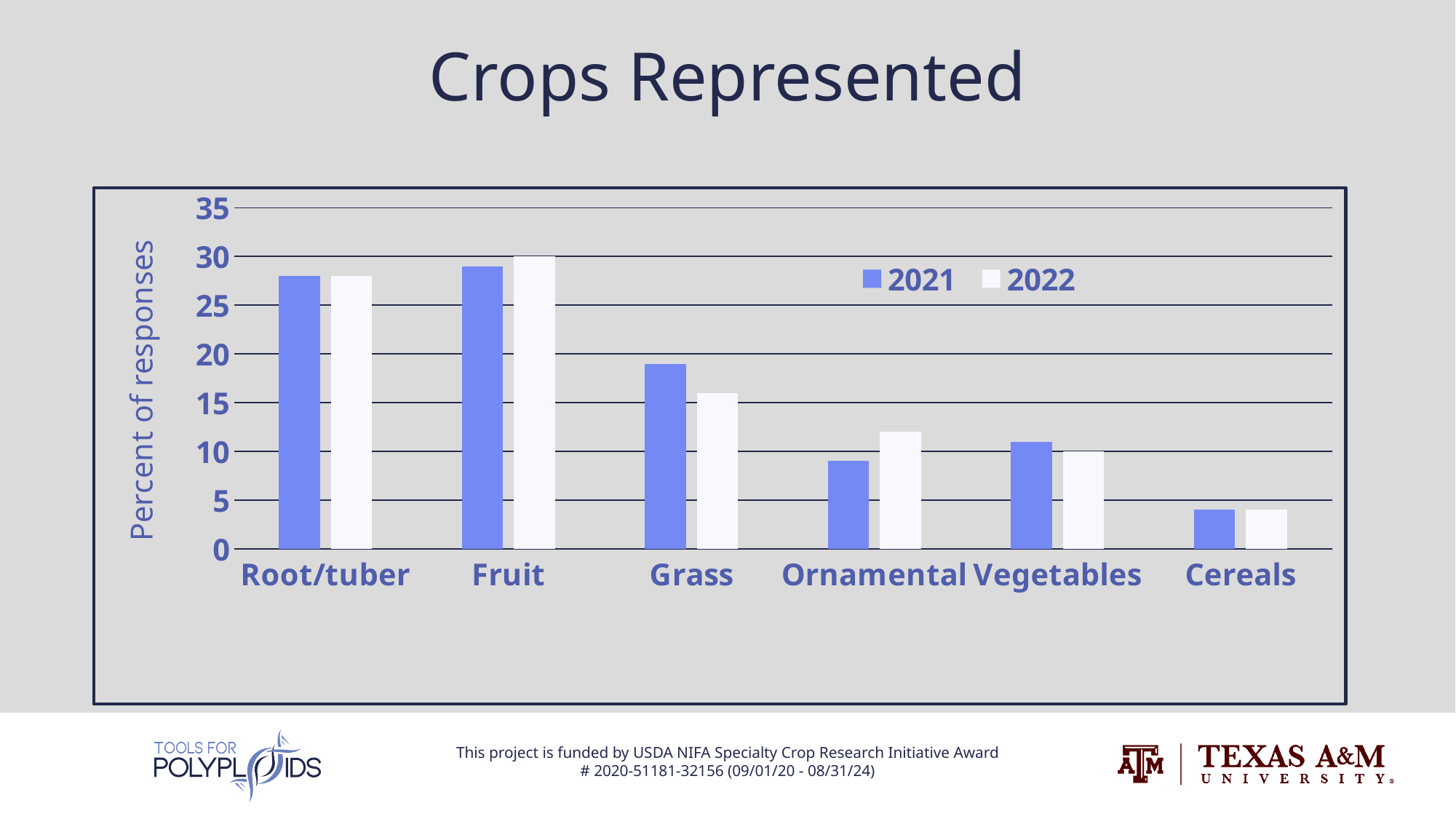
What is the 2022 value for Fruit? 30 Is the 2021 value for Root/tuber greater or less than 25? greater For Ornamental, which year has the larger value, 2021 or 2022? 2022 Which crop category has the highest value for 2021? Fruit What kind of chart is shown on the slide? bar chart How many crop categories are shown on the x axis? 6 For Grass, which year has the larger value, 2021 or 2022? 2021 Which crop category has the lowest value for 2022? Cereals What is the 2022 value for Vegetables? 10 How many series does the legend list? 2 What is the label on the y axis? Percent of responses Is the 2022 value for Cereals greater or less than 5? less